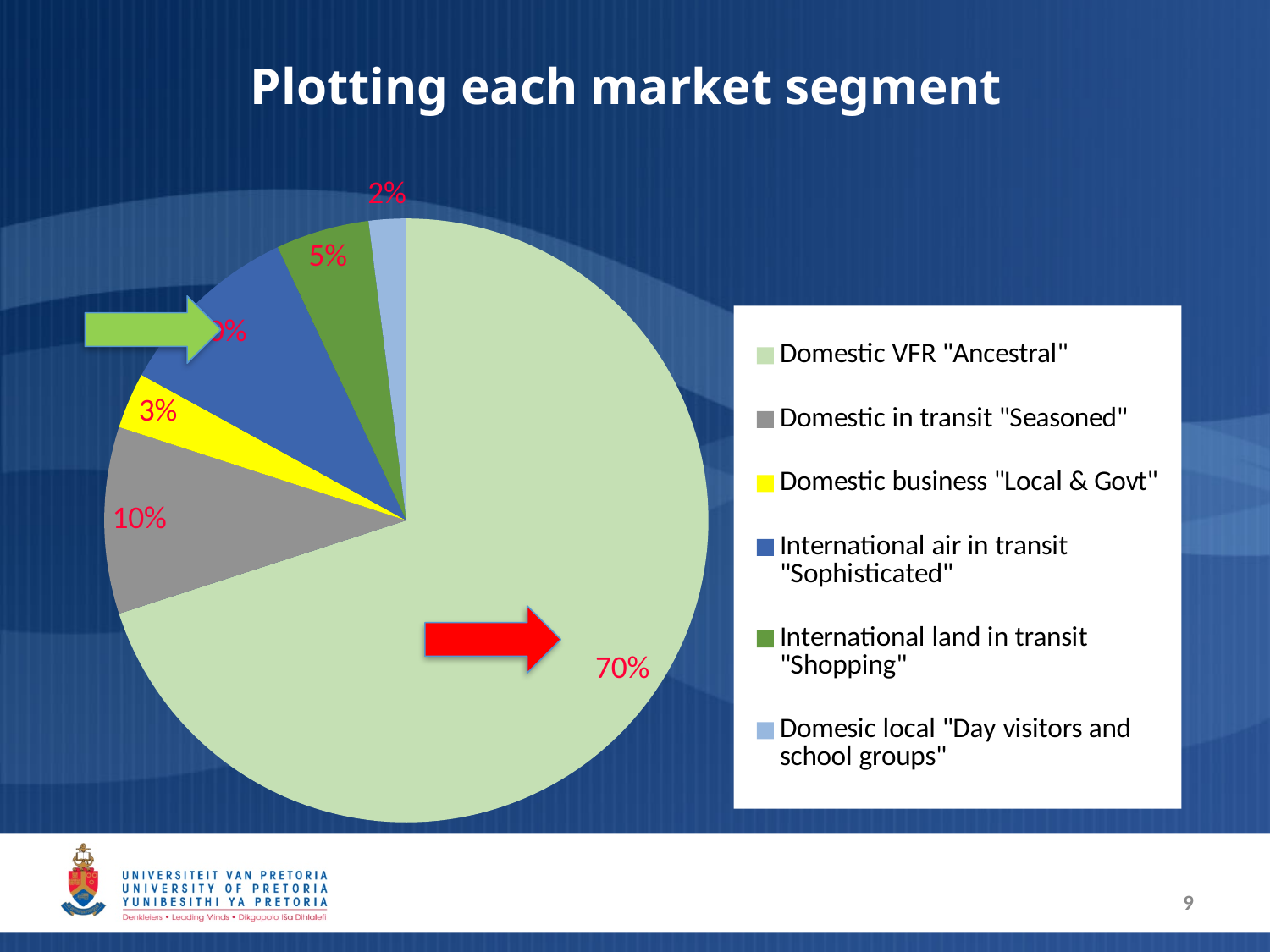
How many market segments are shown in the pie chart's legend? 6 Which market segment has the smallest share of the pie? Domesic local "Day visitors and school groups" What is the difference in percentage points between the Domestic VFR "Ancestral" share and the Domestic in transit "Seasoned" share? 60 percentage points What share of the pie is International land in transit "Shopping"? 5% What share of the pie is Domestic VFR "Ancestral"? 70% What share of the pie is Domestic in transit "Seasoned"? 10% What share of the pie is Domestic business "Local & Govt"? 3% What type of chart is shown on the slide? Pie chart What is the title of the slide's chart? Plotting each market segment What share of the pie is Domesic local "Day visitors and school groups"? 2% Which is larger: the share for International land in transit "Shopping" or Domestic business "Local & Govt"? International land in transit "Shopping" Which market segment has the largest share of the pie? Domestic VFR "Ancestral"